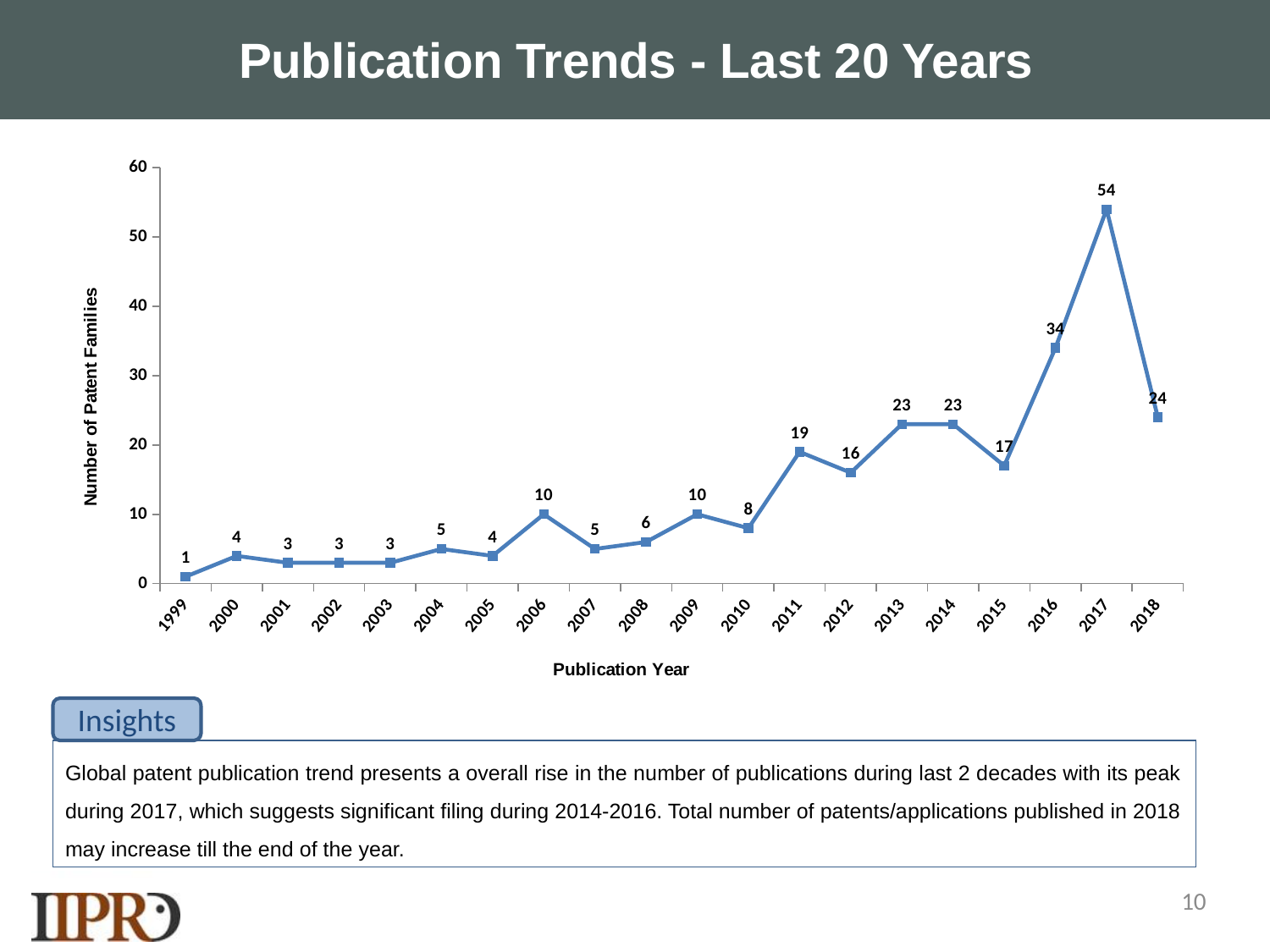
What is the label of the y axis? Number of Patent Families What is the difference between the values for 2017 and 2016? 20 What is the number of patent families for 2011? 19 How many patent families were published in 2017? 54 Does the number of patent families rise or fall from 2017 to 2018? Fall What is the difference between the values for 2018 and 2015? 7 What type of chart is shown on the slide? Line chart Which year has a larger value, 2012 or 2013? 2013 Which publication year has the highest number of patent families? 2017 How many publication years are plotted on the x axis? 20 What is the value for 2018? 24 Which publication year has the lowest number of patent families? 1999